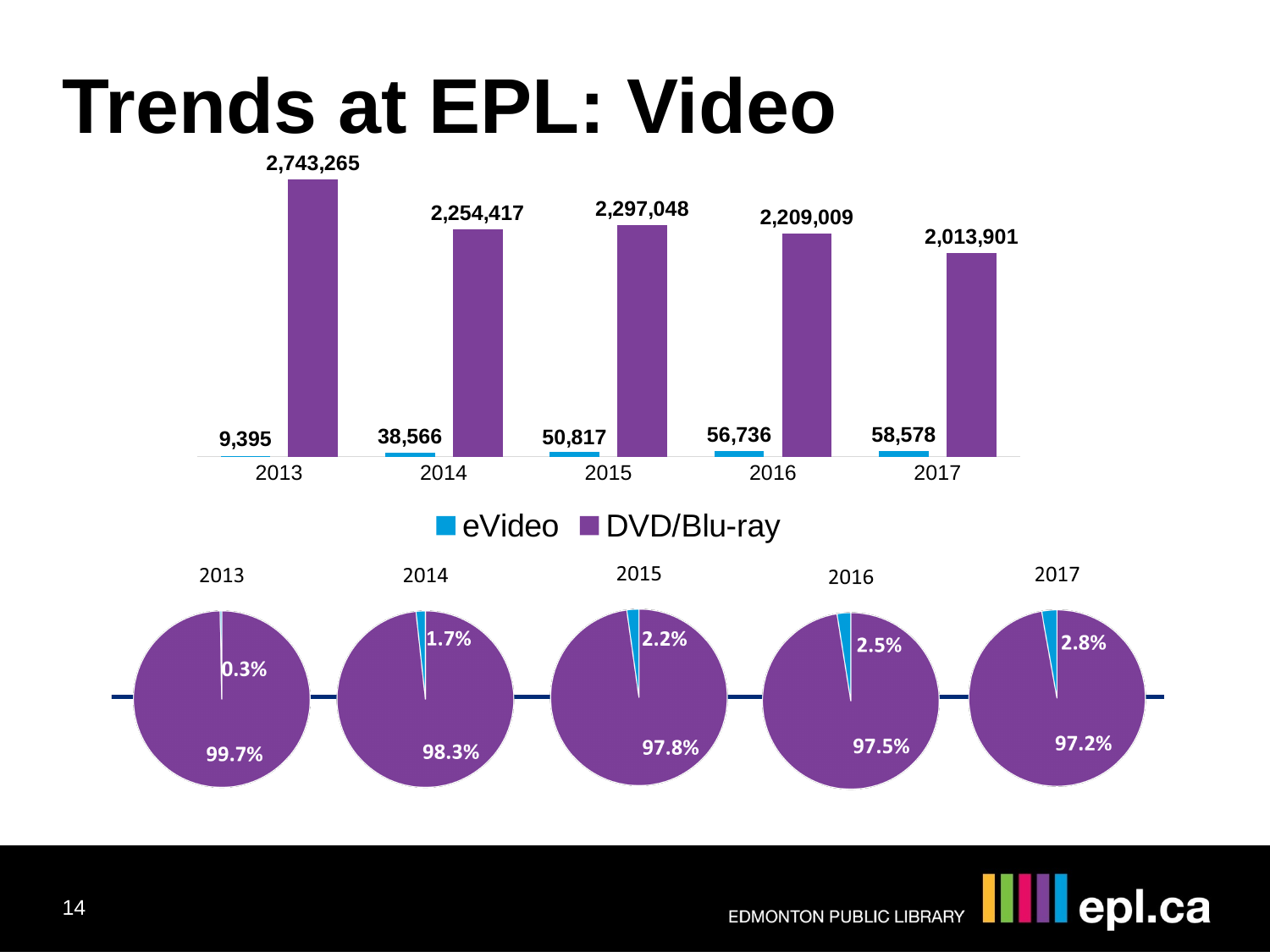
In the bar chart, what is the difference between the DVD/Blu-ray values for 2013 and 2017? 729,364 In the bar chart, which year has the lowest eVideo value? 2013 In the bar chart, which year has the highest DVD/Blu-ray value? 2013 How many pie charts are shown on the slide? 5 In the bar chart, what is the DVD/Blu-ray value for 2013? 2,743,265 In the bar chart, what is the difference between the eVideo values for 2017 and 2013? 49,183 In the bar chart, what is the eVideo value for 2017? 58,578 In the bar chart, do the eVideo values rise or fall from 2013 to 2017? rise In the bar chart, is the DVD/Blu-ray value larger in 2015 or in 2016? 2015 In the 2015 pie chart, what share does the eVideo slice have? 2.2% In the bar chart, how many series does the legend list? 2 In the 2013 pie chart, what share does the DVD/Blu-ray slice have? 99.7%